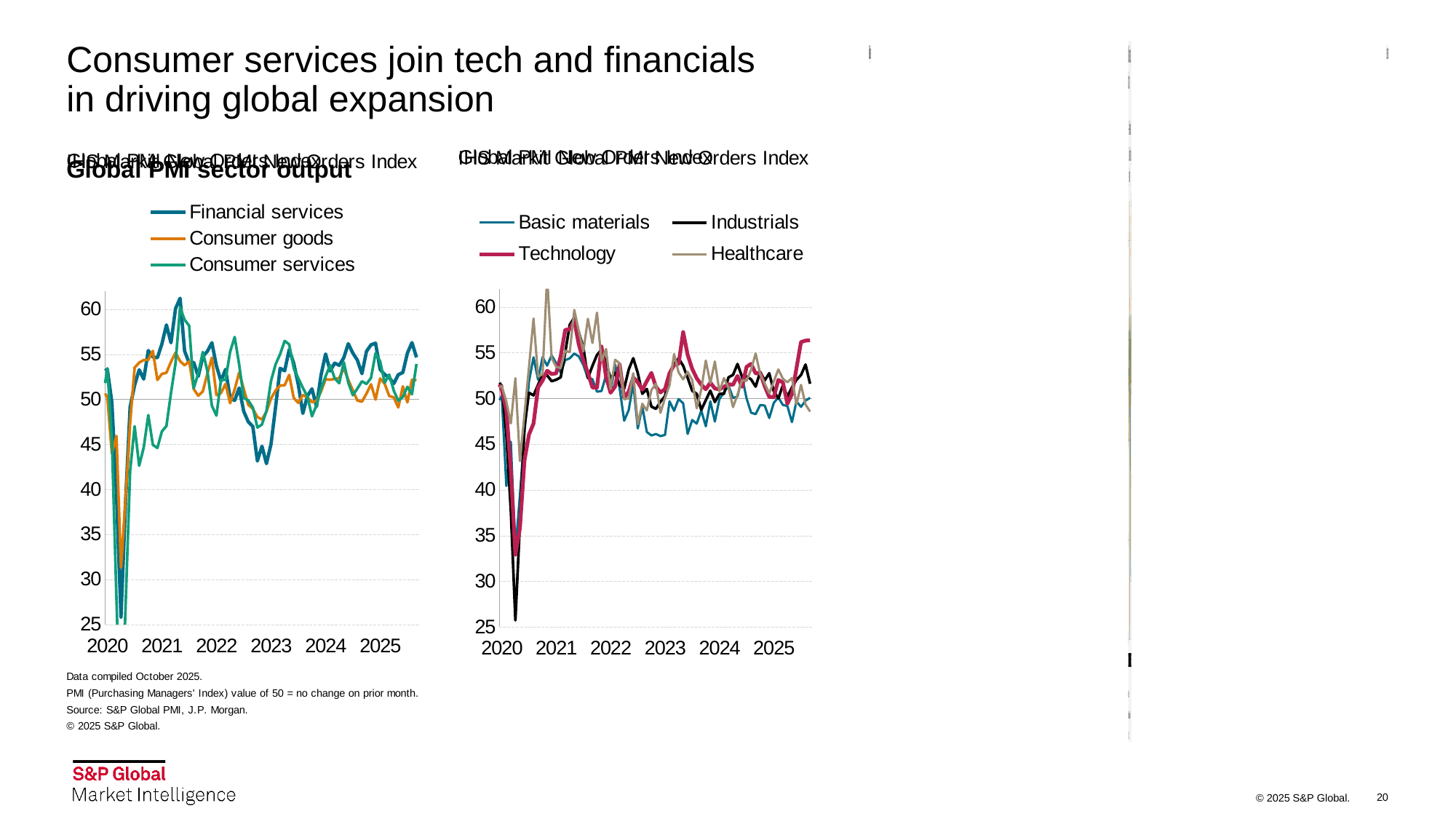
How many series does the legend of the left chart list? 3 In the right chart, is the lowest value of Basic materials in 2023 greater or less than 50? less In the left chart, is the lowest value of Consumer services in 2020 greater or less than 30? less What is the bold title of the left chart? Global PMI sector output In the right chart, is the lowest value of Industrials in 2020 greater or less than 30? less How many series does the legend of the right chart list? 4 What kind of chart is the left chart on the slide? Line chart In the left chart, which series is drawn in orange? Consumer goods In the right chart, do the values of all series rise or fall in the first months of 2020? fall